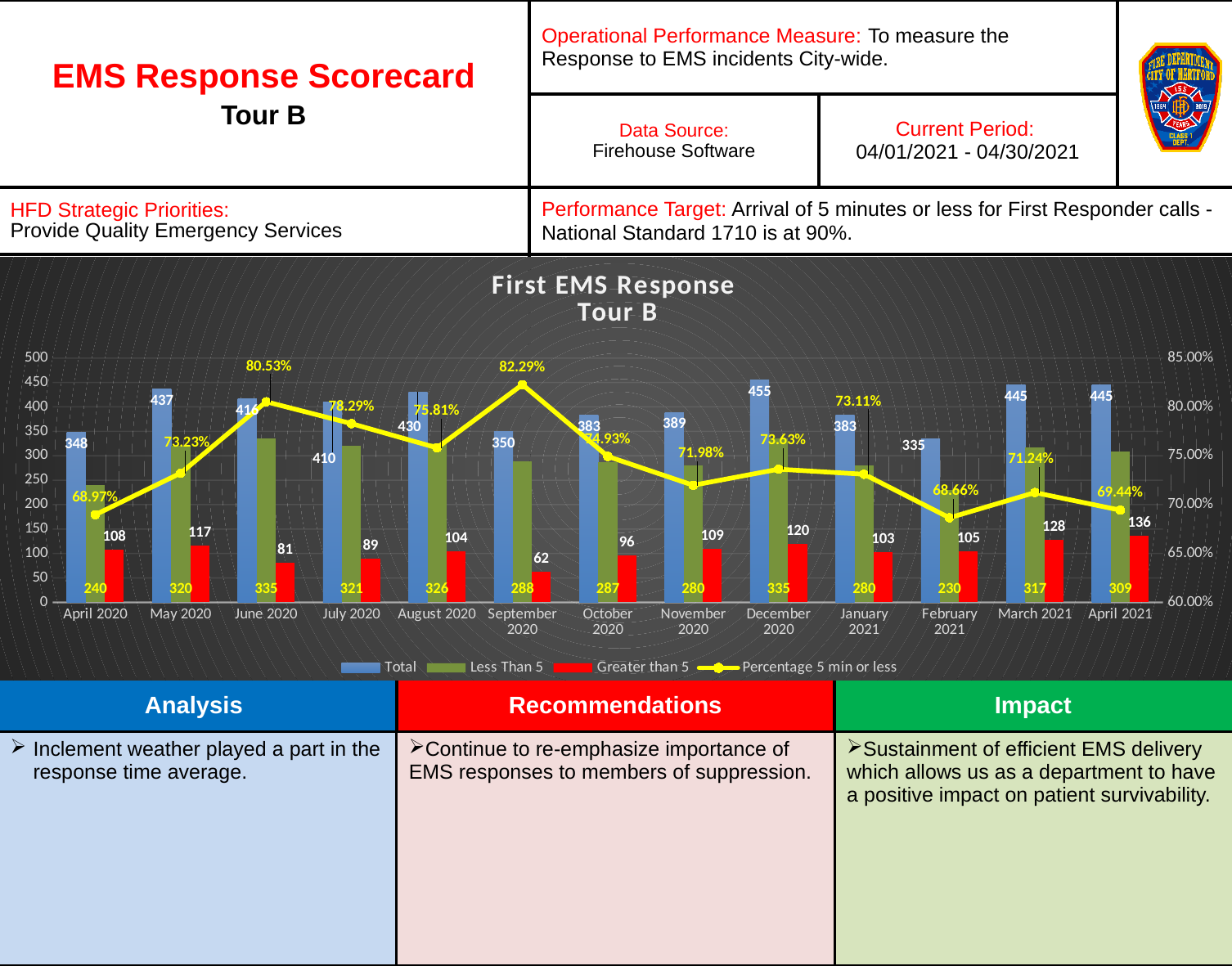
Which month has the larger Greater than 5 value, March 2021 or April 2021? April 2021 How many months are shown on the x axis? 13 Which month has the highest Total value? December 2020 What is the difference between the Total for April 2021 and the Total for April 2020? 97 What is the Less Than 5 value for June 2020? 335 What is the Greater than 5 value for September 2020? 62 What is the Percentage 5 min or less for January 2021? 73.11% How many series does the legend list? 4 What kind of chart is shown? Bar and line chart Which month has the lowest Greater than 5 value? September 2020 What is the Total value for December 2020? 455 Which month has the highest Percentage 5 min or less? September 2020